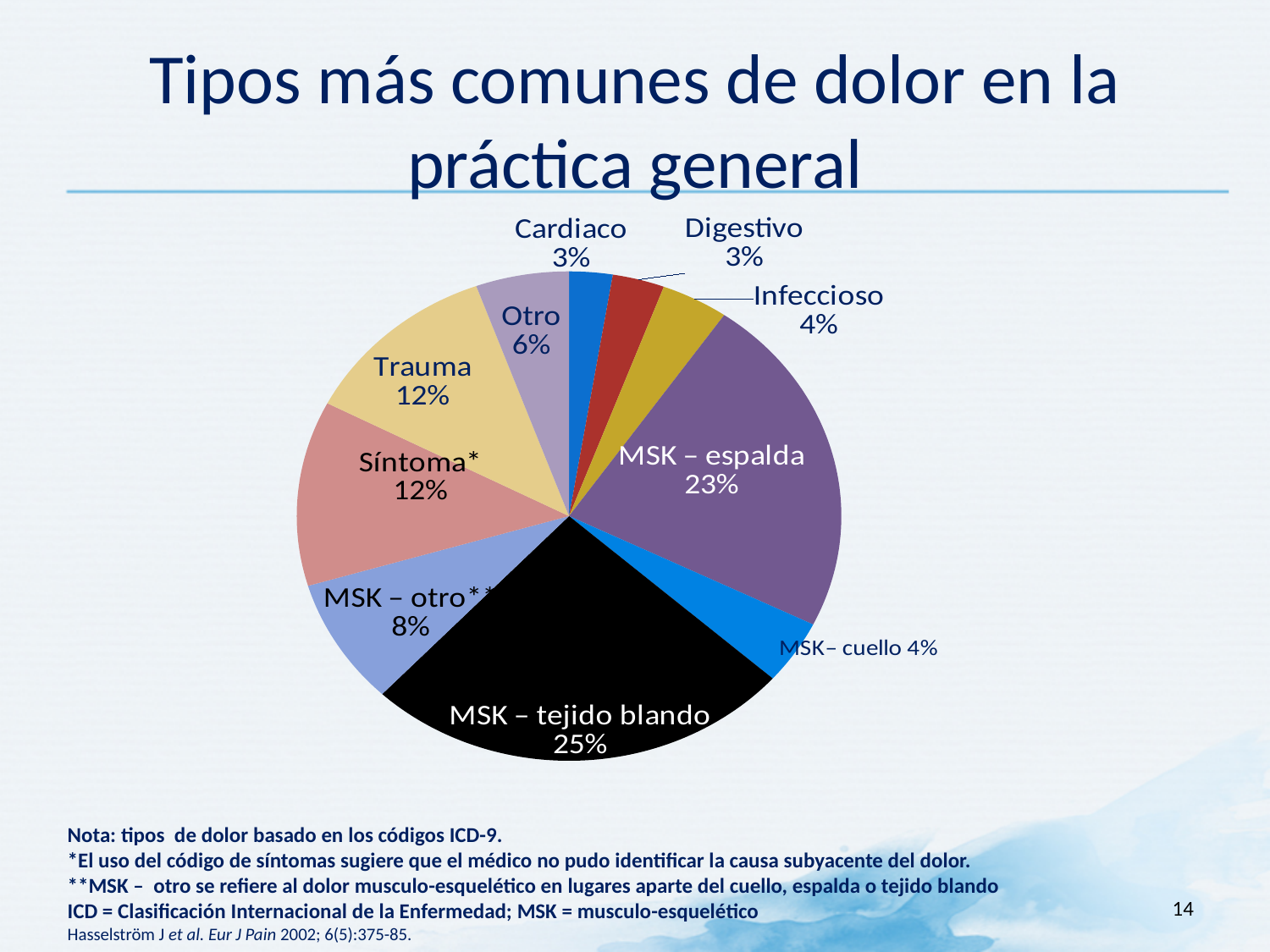
Which category has the smallest share, Otro or Cardiaco? Cardiaco What percentage is shown for Trauma? 12% What is the difference in percentage points between MSK – tejido blando and MSK – espalda? 2 What percentage is shown for MSK – otro? 8% Which category has the largest slice of the pie? MSK – tejido blando What share of the pie does MSK – espalda represent? 23% What share of the pie does MSK – tejido blando represent? 25% What kind of chart is shown on the slide? pie chart How many slices does the pie chart have? 10 What is the title of the slide containing the pie chart? Tipos más comunes de dolor en la práctica general What is the difference in percentage points between Trauma and Otro? 6 What percentage is shown for Infeccioso? 4%